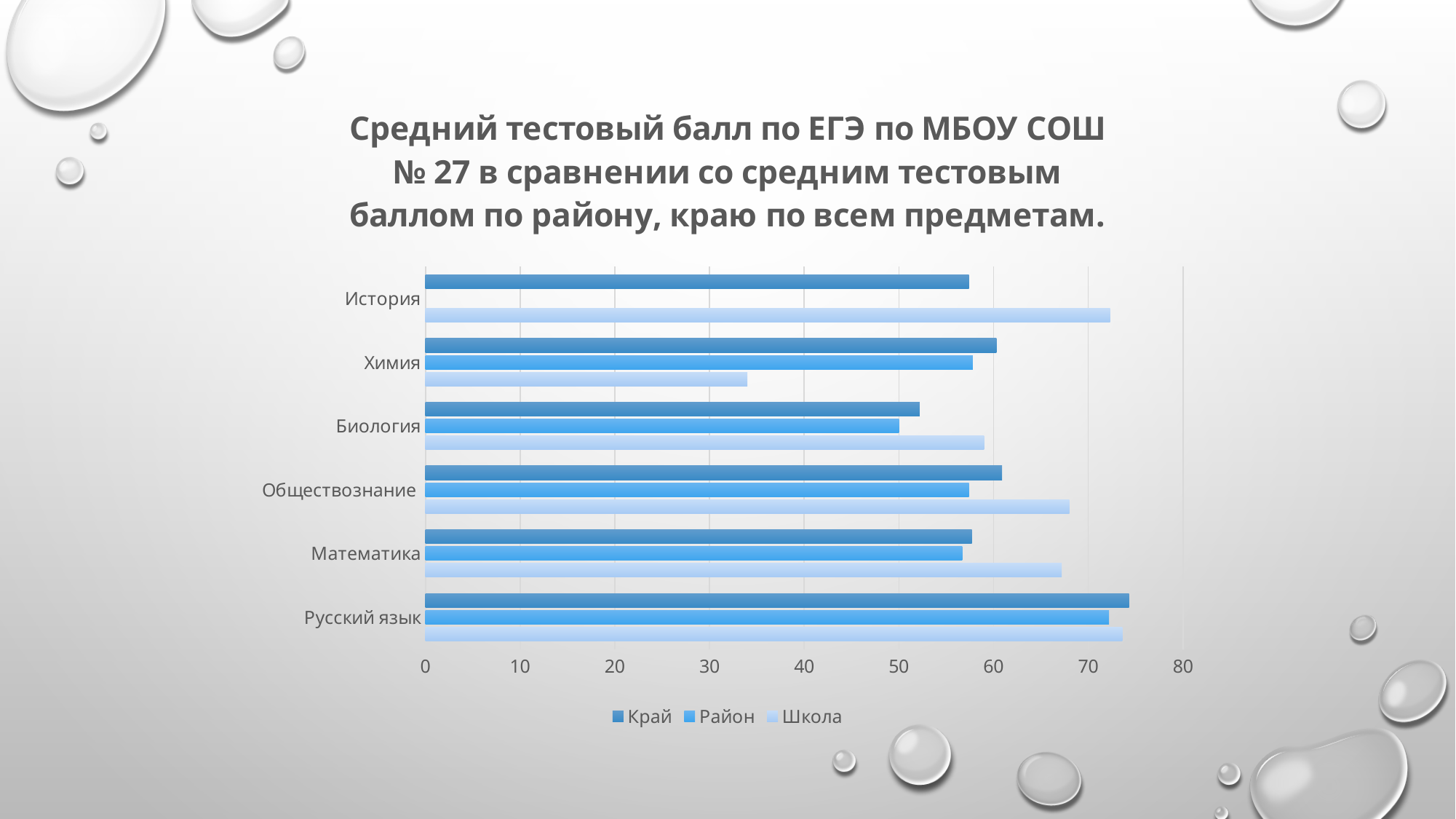
Which subject has the highest value for Край? Русский язык Which subject has the lowest value for Школа? Химия In Химия, which is larger: the value for Край or the value for Школа? Край Is the value for Край in Русский язык greater or less than 70? greater Is the value for Район in Математика greater or less than 50? greater Is the value for Школа in Химия greater or less than 40? less How many series does the legend list? 3 In Биология, which is larger: the value for Школа or the value for Район? Школа How many subjects (categories) are shown on the chart? 6 What kind of chart is shown on the slide? bar chart What are the three series named in the legend? Край, Район, Школа